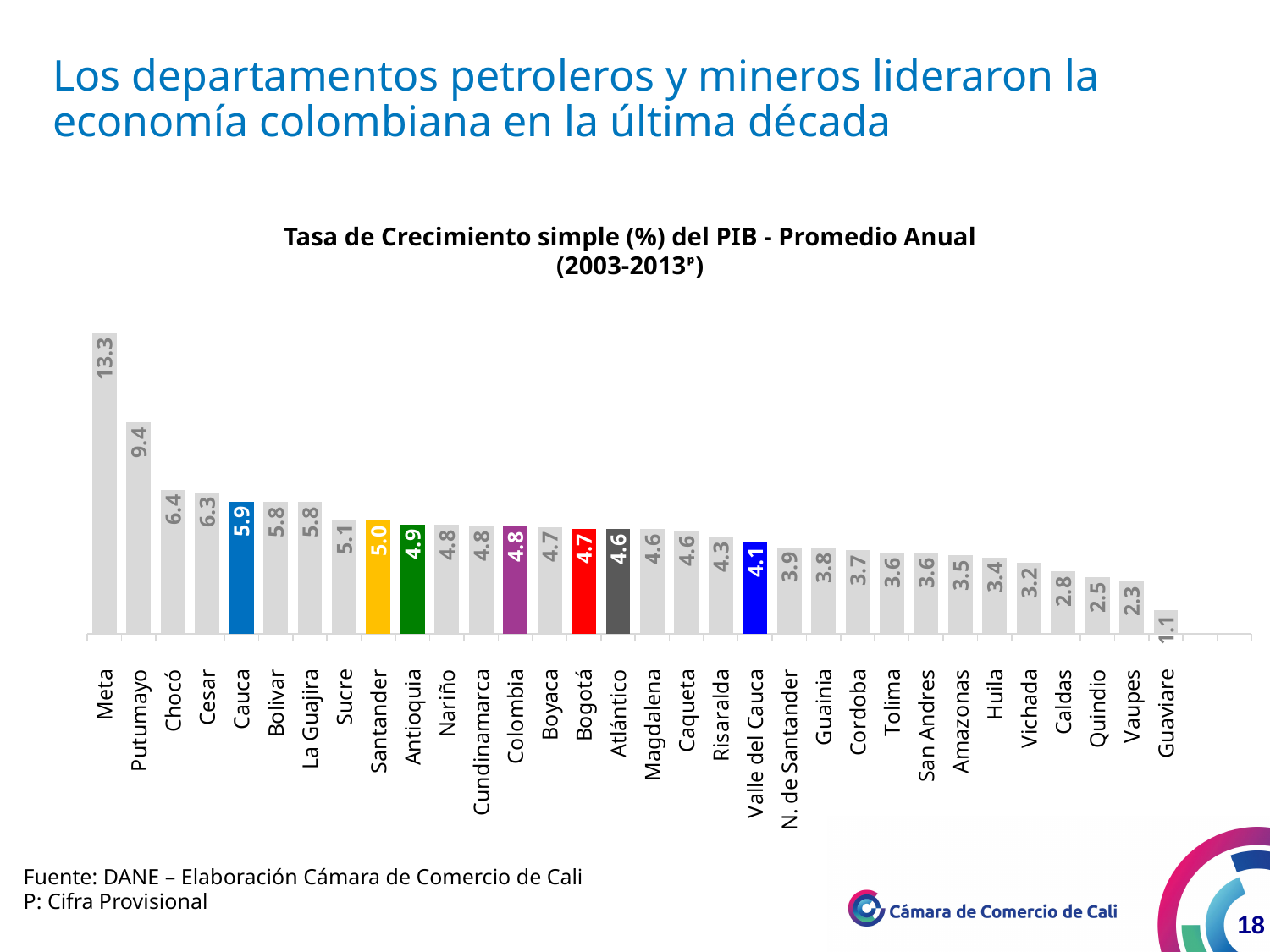
How many bars are shown in the chart? 32 What is the value for Valle del Cauca? 4.1 What is the value for Meta? 13.3 What kind of chart is shown on the slide? Bar chart Which department has the lowest growth rate? Guaviare What is the value for Colombia? 4.8 Do the values rise or fall from left to right along the x axis? Fall What is the title of the chart? Tasa de Crecimiento simple (%) del PIB - Promedio Anual (2003-2013ᴾ) What is the difference between the values for Meta and Putumayo? 3.9 What is the value for Santander? 5.0 Which is larger, the value for Cauca or the value for Bogotá? Cauca Which department has the highest growth rate? Meta